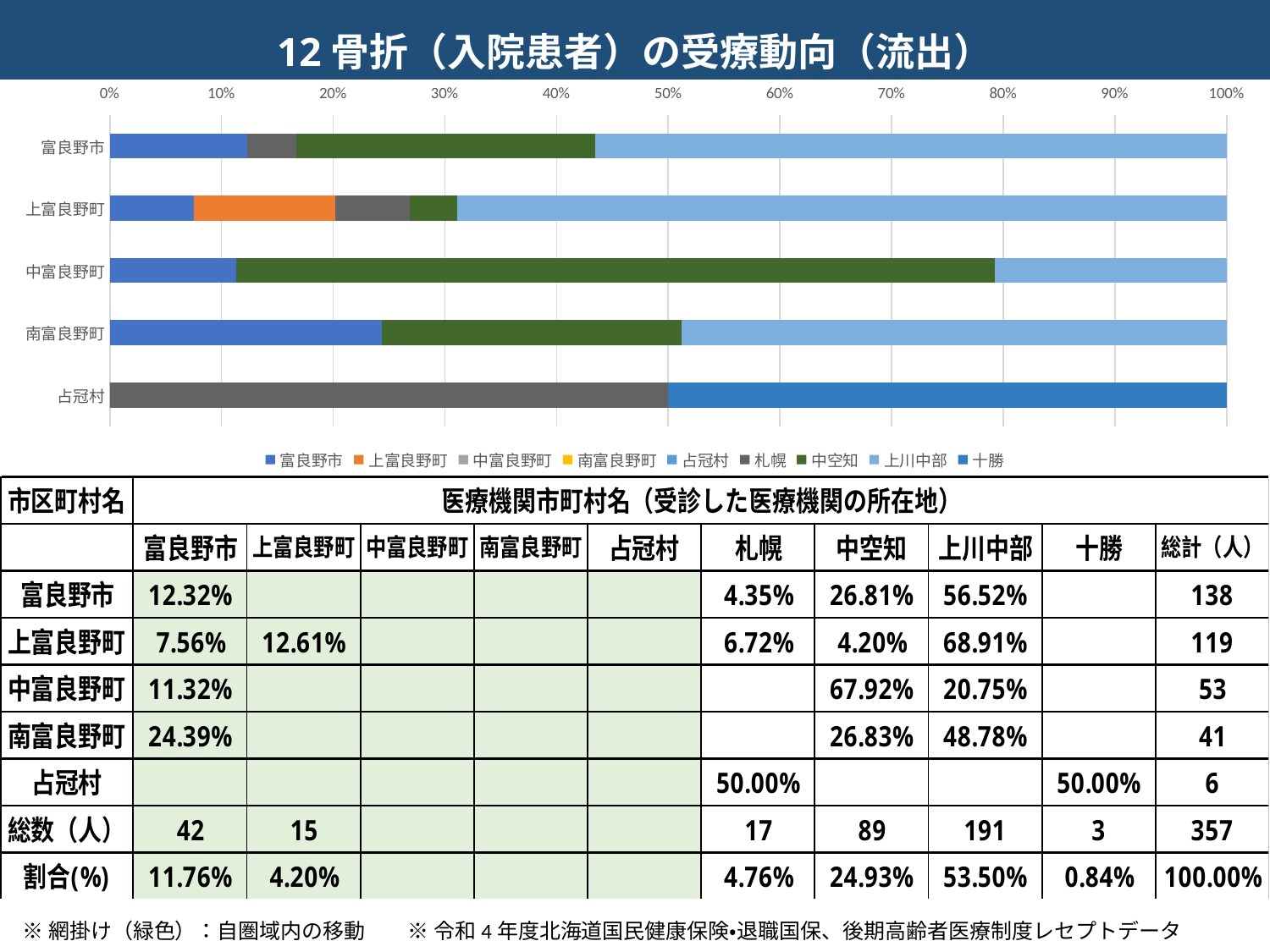
Which is larger: the 中空知 segment for 中富良野町 or the 中空知 segment for 南富良野町? 中富良野町 What is the difference between the 上川中部 segment and the 中空知 segment for 南富良野町? 21.95% How many categories (municipalities) are plotted on the y axis of the chart? 5 Is the 上川中部 segment for 富良野市 greater or less than 50%? greater What is the value of the 上川中部 segment for 富良野市? 56.52% What is the value of the 中空知 segment for 中富良野町? 67.92% Which category has the largest 上川中部 segment? 上富良野町 What is the value of the 上富良野町 segment for 上富良野町? 12.61% What is the title of the chart? 12 骨折（入院患者）の受療動向（流出） How many series does the chart legend list? 9 What kind of chart is shown on the slide? bar chart What is the value of the 札幌 segment for 占冠村? 50.00%